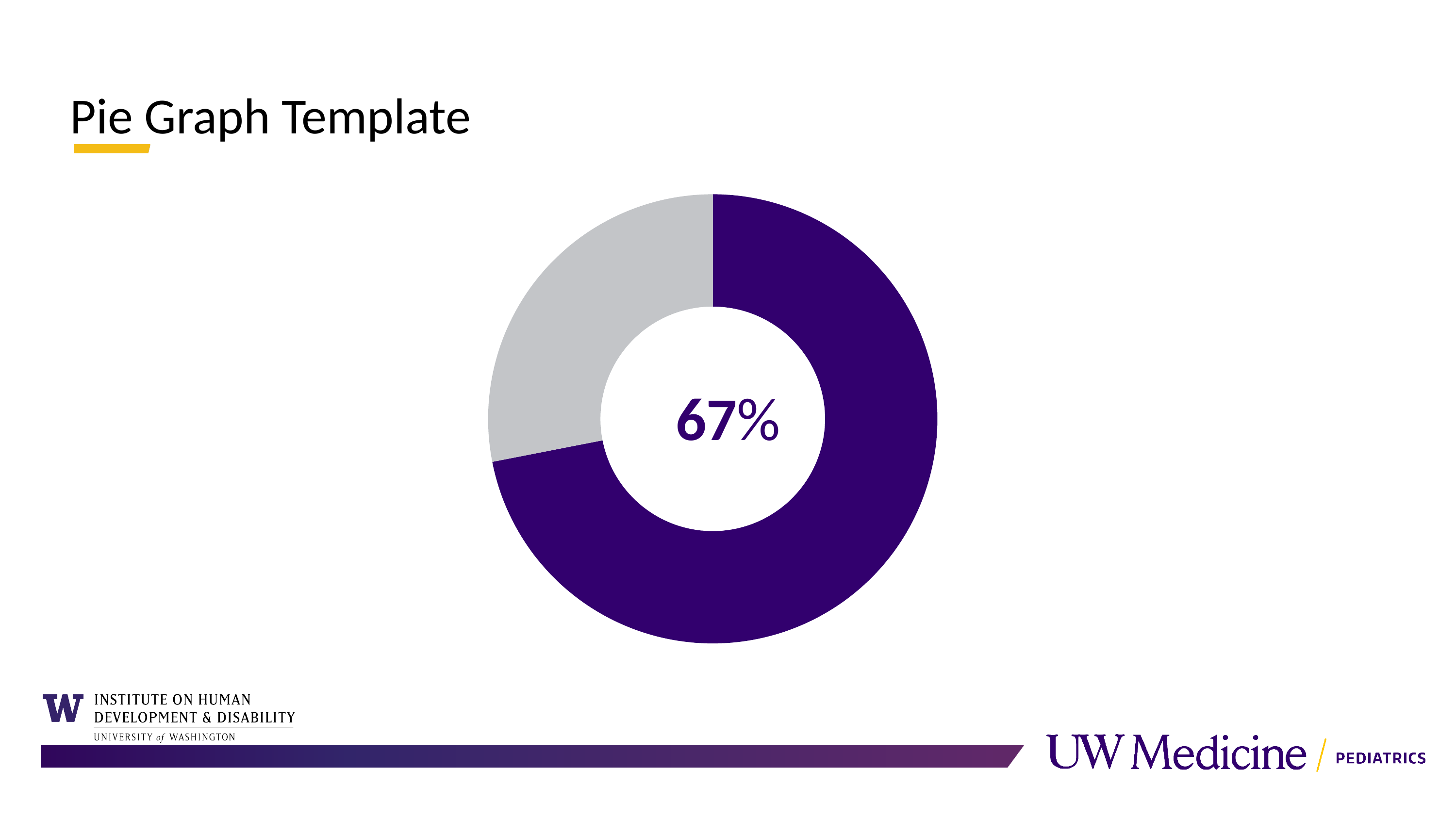
Which slice is the smallest? The grey slice Which slice is larger, the purple one or the grey one? Purple Is the purple slice's share greater or less than 50%? greater What kind of chart is shown on the slide? Pie chart (donut) How many slices does the chart have? 2 Is the grey slice's share greater or less than 50%? less What colour is the largest slice of the chart? Purple What percentage is printed in the centre of the chart? 67% What is the title of the slide containing the chart? Pie Graph Template